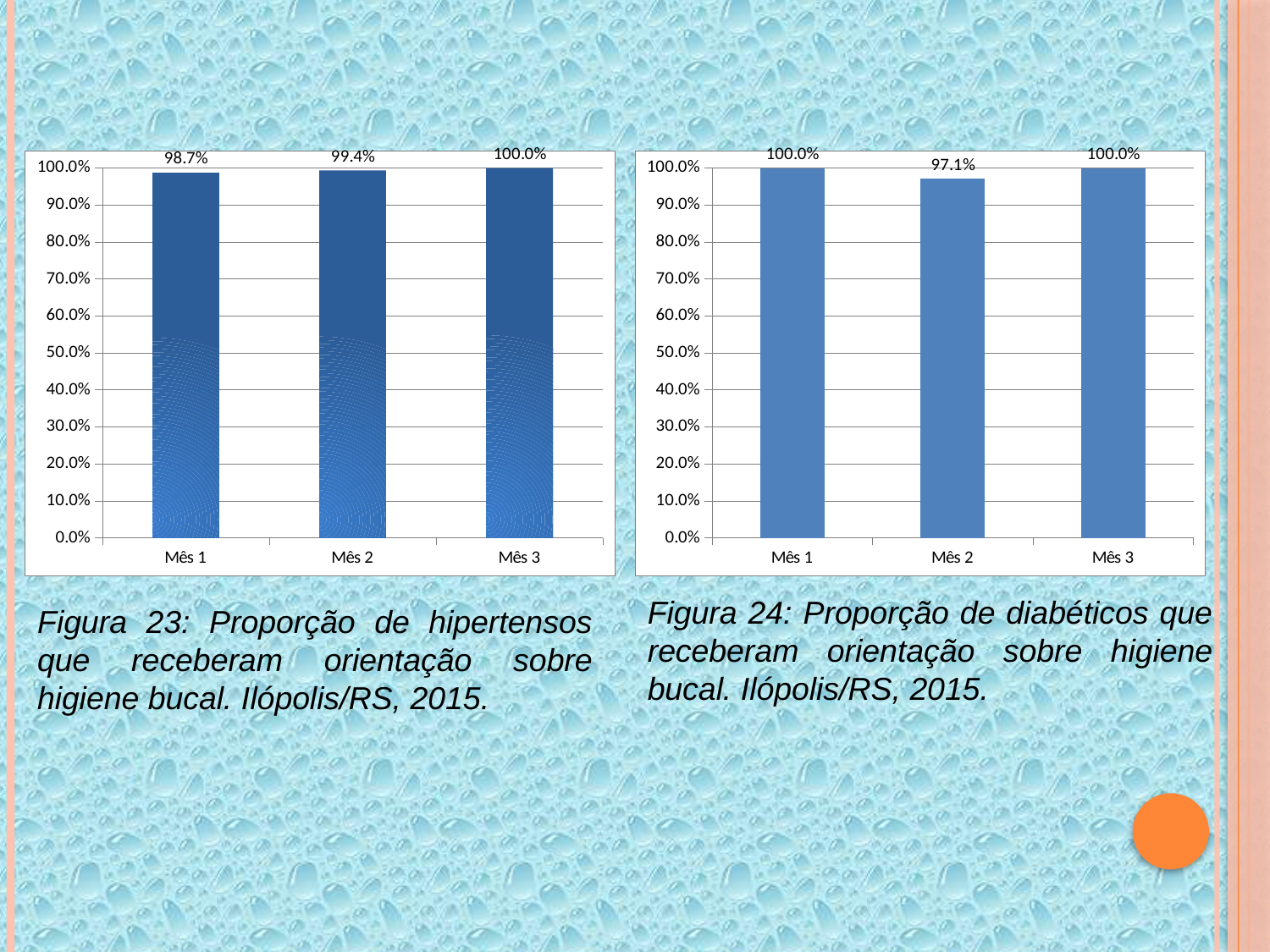
In the right chart (Figura 24), what is the value for Mês 3? 100.0% In the right chart (Figura 24), which is larger: the value for Mês 1 or Mês 2? Mês 1 In the left chart (Figura 23), what is the difference between the values for Mês 3 and Mês 1? 1.3% In the right chart (Figura 24), which month has the lowest value? Mês 2 In the left chart (Figura 23), which month has the lowest value? Mês 1 In the right chart (Figura 24), what is the difference between the values for Mês 1 and Mês 2? 2.9% How many months are shown on the x axis of the left chart (Figura 23)? 3 In the left chart (Figura 23), what is the value for Mês 1? 98.7% In the right chart (Figura 24), what is the value for Mês 2? 97.1% What kind of chart is the right chart (Figura 24)? Bar chart In the left chart (Figura 23), do the values rise or fall from Mês 1 to Mês 3? Rise In the left chart (Figura 23), what is the value for Mês 2? 99.4%